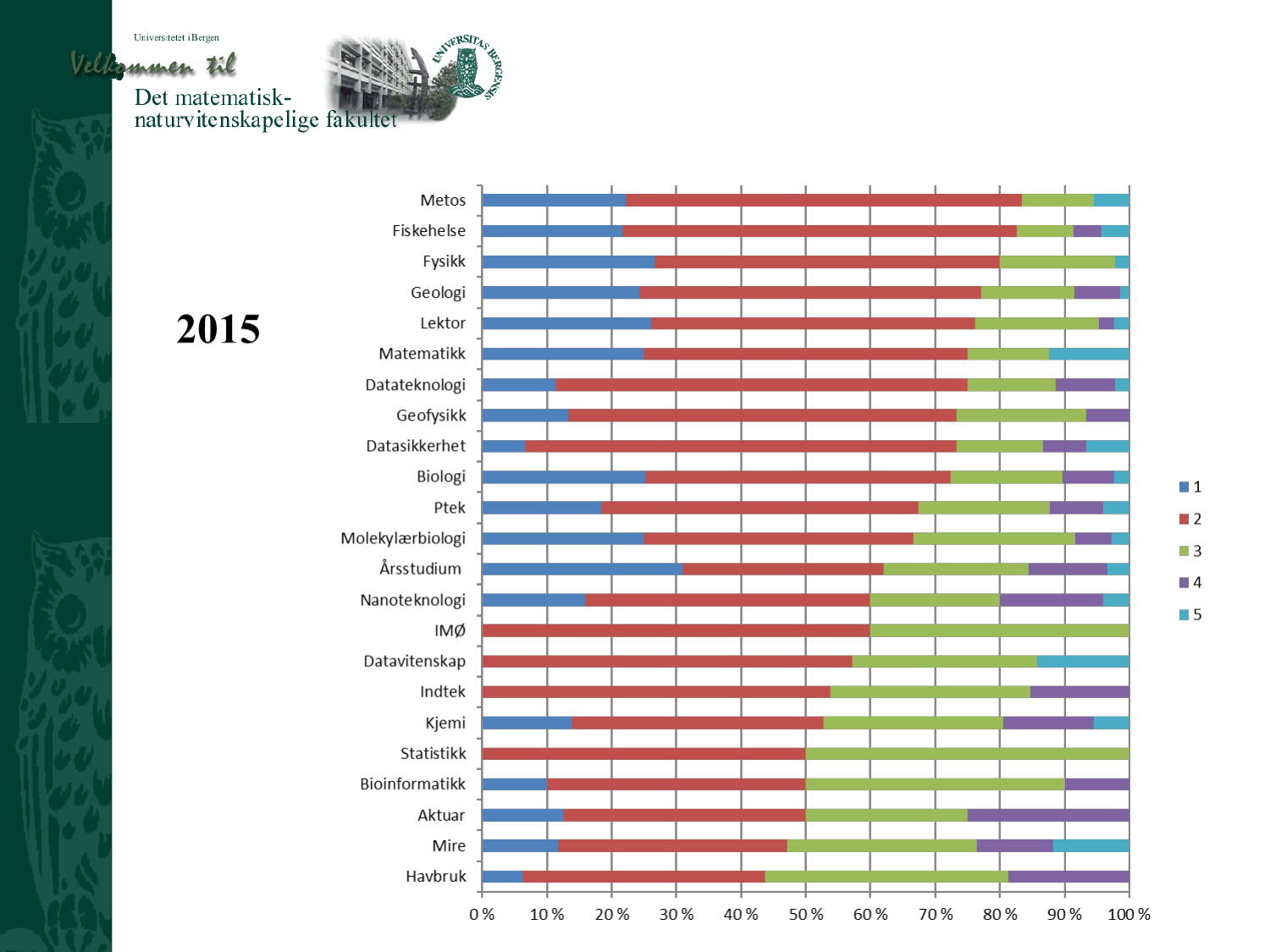
Which has the larger series 1 segment, Årsstudium or Havbruk? Årsstudium Is the series 3 segment for Statistikk greater or less than 40 %? greater Is the series 1 segment for Fysikk greater or less than 20 %? greater What does each stacked bar in the chart add up to? 100 % Which has the larger series 2 segment, Datasikkerhet or Havbruk? Datasikkerhet What are the legend entries of the chart? 1, 2, 3, 4, 5 How many series does the chart's legend list? 5 How many categories (study programmes) are listed on the vertical axis of the chart? 23 Moving down the chart from Metos at the top to Havbruk at the bottom, does the combined share of series 1 and 2 increase or decrease? decrease What kind of chart is shown on the slide? stacked bar chart Which year is shown next to the chart? 2015 Is the series 1 segment for Datasikkerhet greater or less than 10 %? less